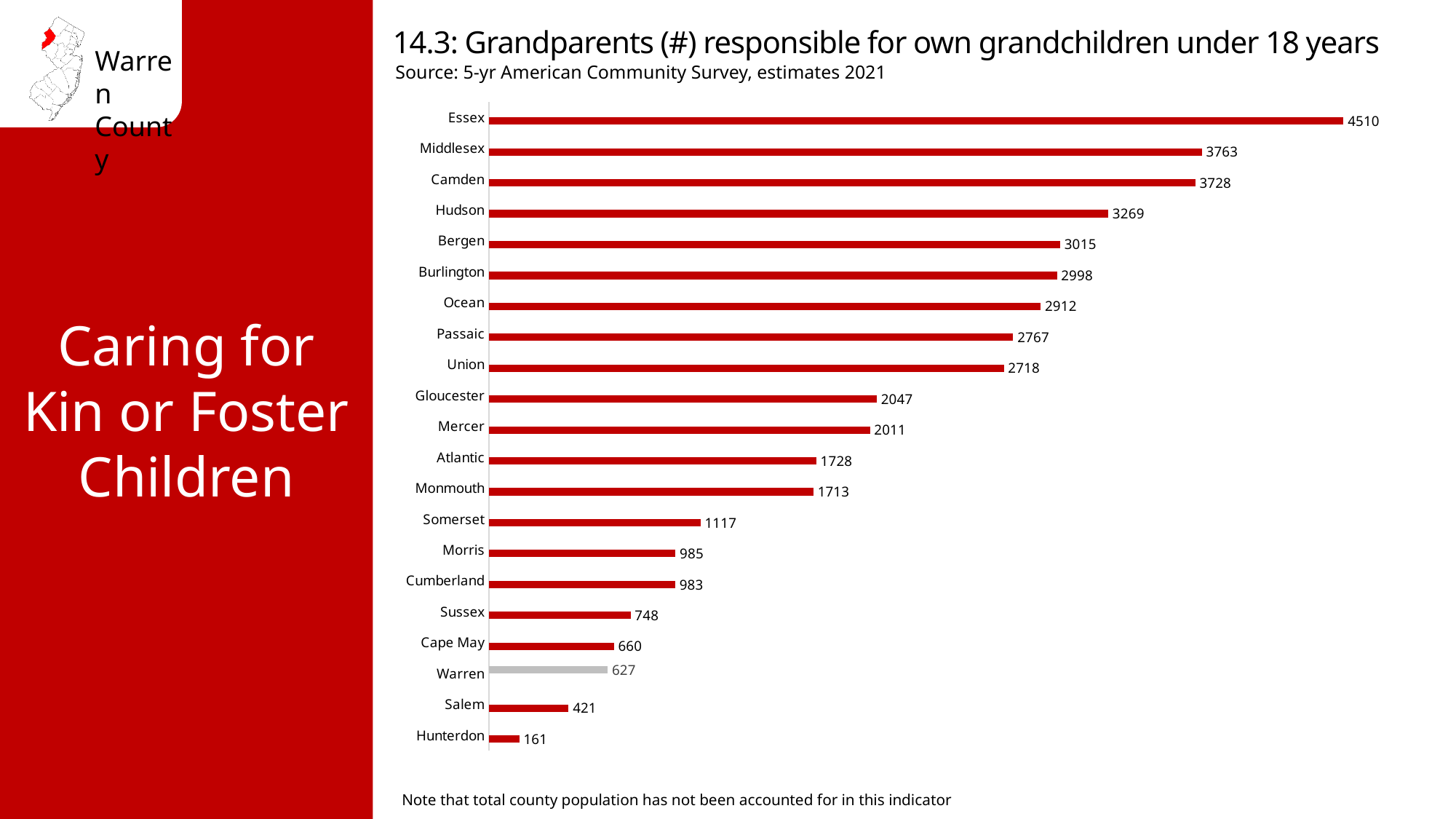
What kind of chart is shown on the slide? Bar chart What is the difference between the values for Warren and Salem? 206 Which county has the lowest value? Hunterdon Which county has the highest value? Essex What is the difference between the values for Essex and Middlesex? 747 What is the value for Warren? 627 How many counties are shown in the chart? 21 Which is larger, the value for Sussex or the value for Cape May? Sussex Which is larger, the value for Hudson or the value for Bergen? Hudson What is the value for Gloucester? 2047 Which county's bar is shown in grey rather than red? Warren What is the value for Essex? 4510